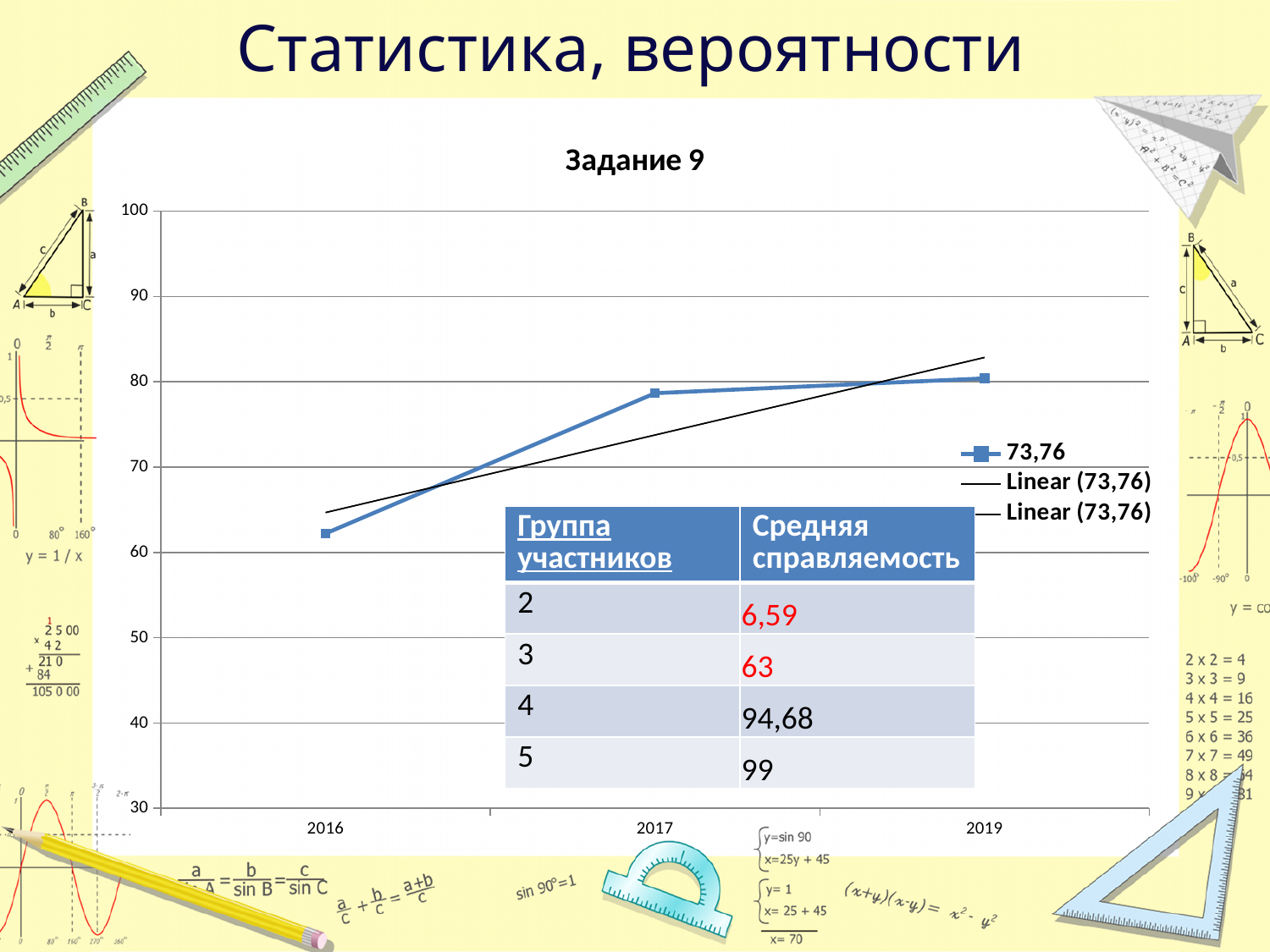
Which year has the lowest value on the chart? 2016 What is the name of the data series shown with square markers in the legend? 73,76 How many years are plotted along the x axis of the chart? 3 What is the title of the chart? Задание 9 What kind of chart is shown under the title "Задание 9"? line chart Do the values rise or fall from 2016 to 2019? rise Is the value for 2019 greater or less than 70? greater Is the value for 2016 greater or less than 70? less Is the value for 2017 greater or less than 90? less How many entries does the chart legend list? 3